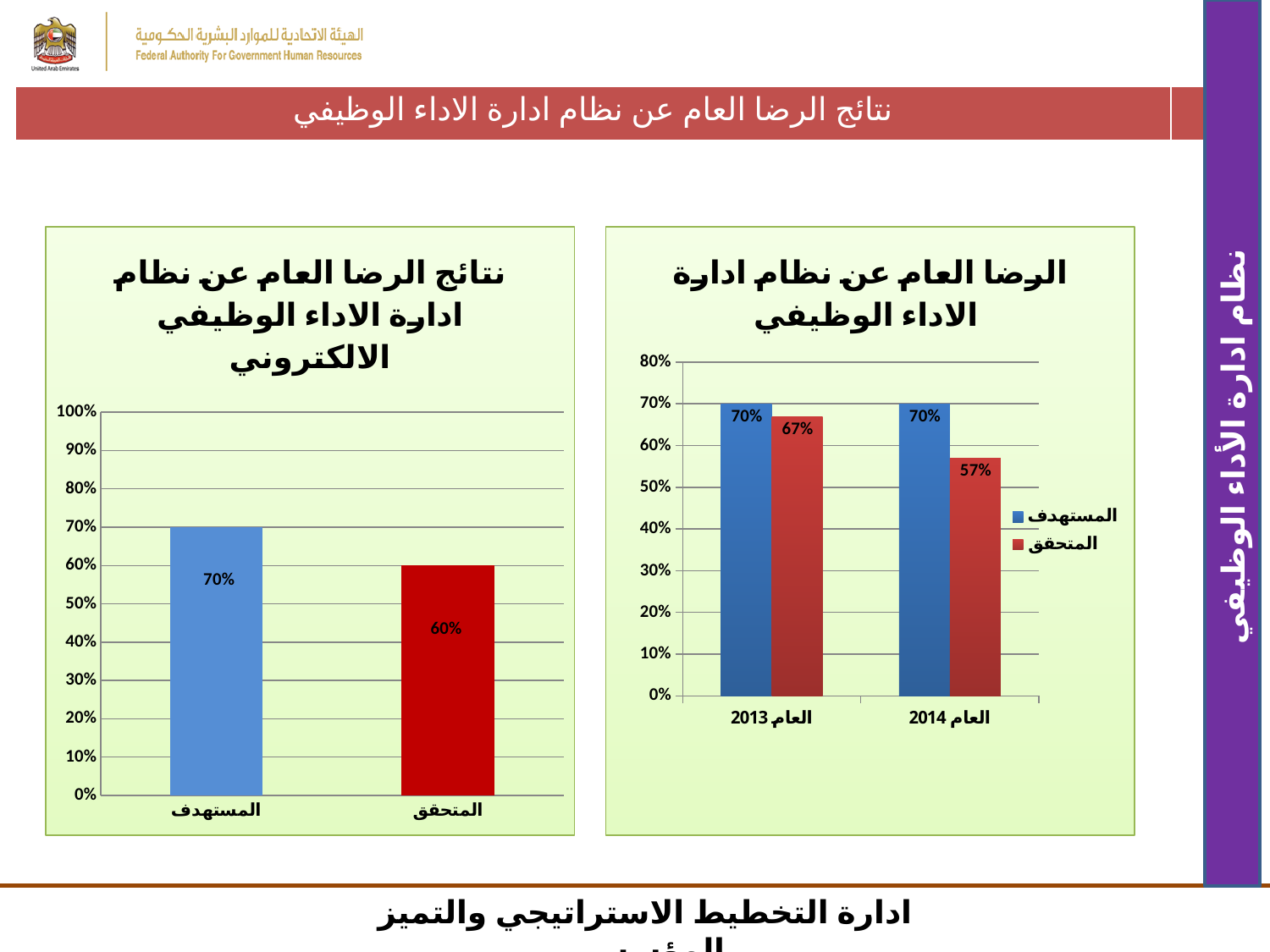
What type of chart is the left chart (نتائج الرضا العام عن نظام ادارة الاداء الوظيفي الالكتروني)? bar chart In the left chart (نتائج الرضا العام عن نظام ادارة الاداء الوظيفي الالكتروني), how many bars are plotted? 2 In the right chart (الرضا العام عن نظام ادارة الاداء الوظيفي), what is the value of المتحقق for العام 2014? 57% In the right chart (الرضا العام عن نظام ادارة الاداء الوظيفي), does the value of المتحقق rise or fall from العام 2013 to العام 2014? fall In the right chart (الرضا العام عن نظام ادارة الاداء الوظيفي), what is the value of المستهدف for العام 2014? 70% In the right chart (الرضا العام عن نظام ادارة الاداء الوظيفي), how many series does the legend list? 2 In the left chart (نتائج الرضا العام عن نظام ادارة الاداء الوظيفي الالكتروني), what is the value for المتحقق? 60% In the right chart (الرضا العام عن نظام ادارة الاداء الوظيفي), which year has the lower المتحقق value? العام 2014 In the right chart (الرضا العام عن نظام ادارة الاداء الوظيفي), what is the difference between المستهدف and المتحقق for العام 2014? 13% In the left chart (نتائج الرضا العام عن نظام ادارة الاداء الوظيفي الالكتروني), what is the value for المستهدف? 70% In the left chart (نتائج الرضا العام عن نظام ادارة الاداء الوظيفي الالكتروني), what is the difference between المستهدف and المتحقق? 10% In the right chart (الرضا العام عن نظام ادارة الاداء الوظيفي), what is the value of المتحقق for العام 2013? 67%